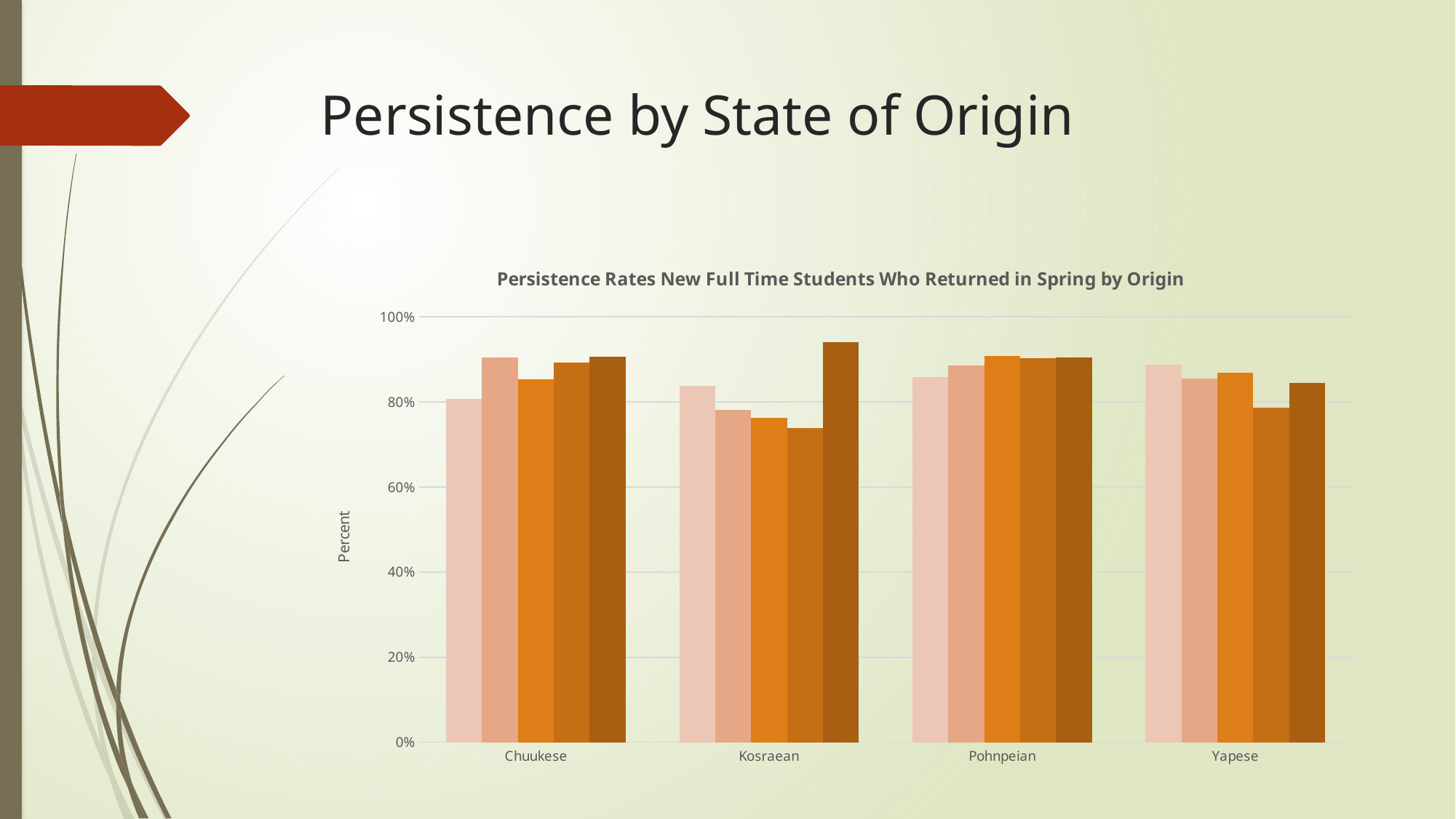
Is the shortest bar for Kosraean greater or less than 80%? less How many origin categories are shown on the x axis? 4 Are all of the bars for Pohnpeian greater or less than 80%? greater Is the tallest bar for Chuukese greater or less than 100%? less How many bars are plotted for each origin category? 5 What kind of chart is shown on the slide? Bar chart What is the title of the chart? Persistence Rates New Full Time Students Who Returned in Spring by Origin Which origin category contains the shortest bar in the chart? Kosraean What is the label on the vertical axis of the chart? Percent Which origin category contains the tallest bar in the chart? Kosraean